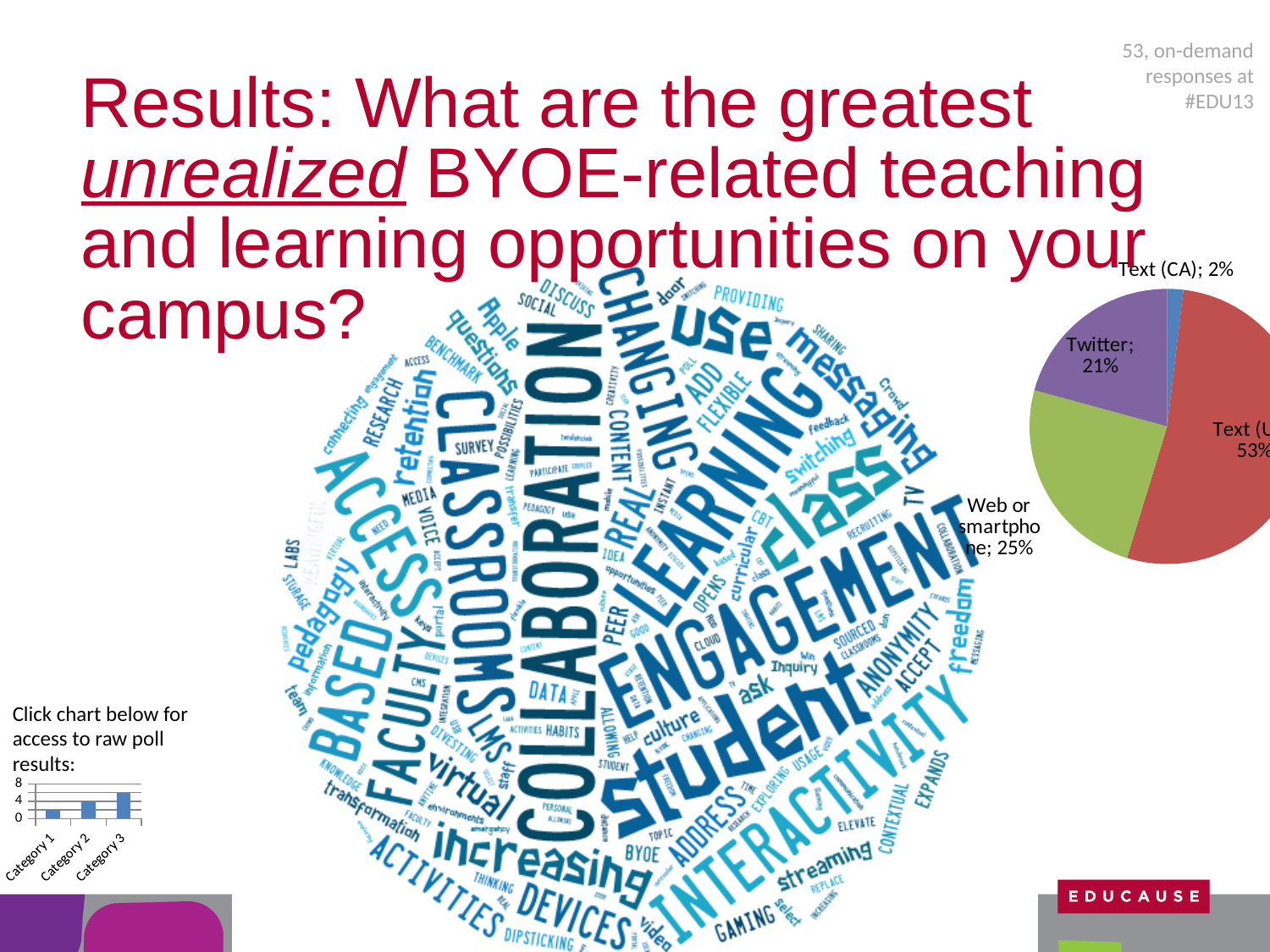
In the bottom-left bar chart, is the value for Category 1 greater or less than 4? less What kind of chart is shown in the top right of the slide? Pie chart How many slices does the pie chart have? 4 What kind of chart is shown in the bottom left of the slide? Bar chart In the pie chart, what share of responses is labelled Text (CA)? 2% In the pie chart, what is the difference in percentage points between the Web or smartphone slice and the Twitter slice? 4% How many categories does the bar chart in the bottom left show? 3 In the pie chart, which labelled slice is the smallest? Text (CA) In the pie chart, what share of responses is labelled Web or smartphone? 25% In the bottom-left bar chart, which category has the highest value? Category 3 In the pie chart, which is larger: the Twitter slice or the Web or smartphone slice? Web or smartphone In the pie chart, what share of responses is labelled Twitter? 21%